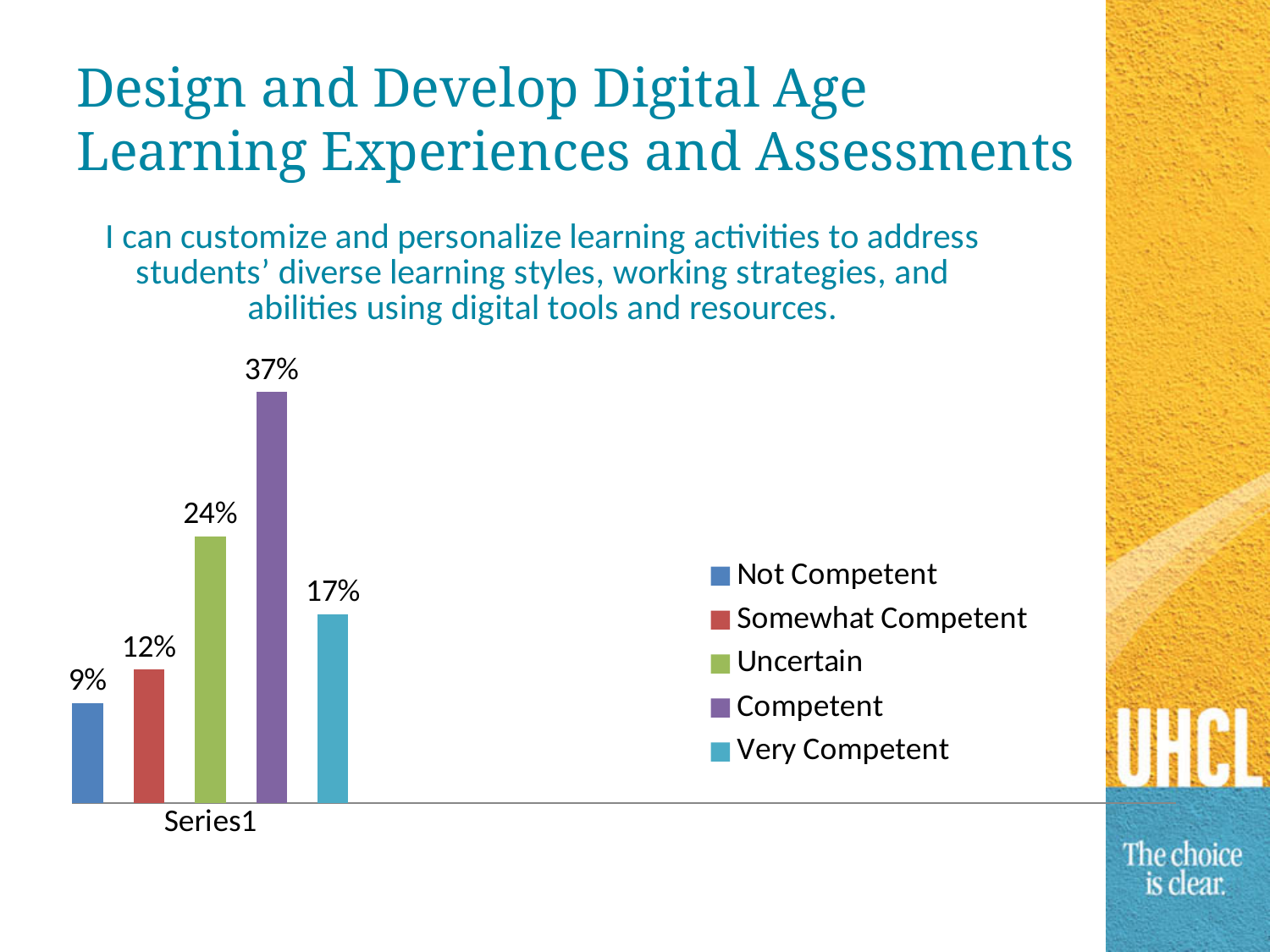
Which is larger, Uncertain or Very Competent? Uncertain Which category has the highest value? Competent Which category has the lowest value? Not Competent What is the value for Not Competent? 9% What is the value for Very Competent? 17% What colour is the bar for Competent? Purple What percentage of respondents rated themselves as Competent? 37% What is the value for Uncertain? 24% What is the difference between the Competent and Uncertain values? 13% How many series does the legend list? 5 What is the difference between the Very Competent and Somewhat Competent values? 5% What kind of chart is shown on the slide? Bar chart